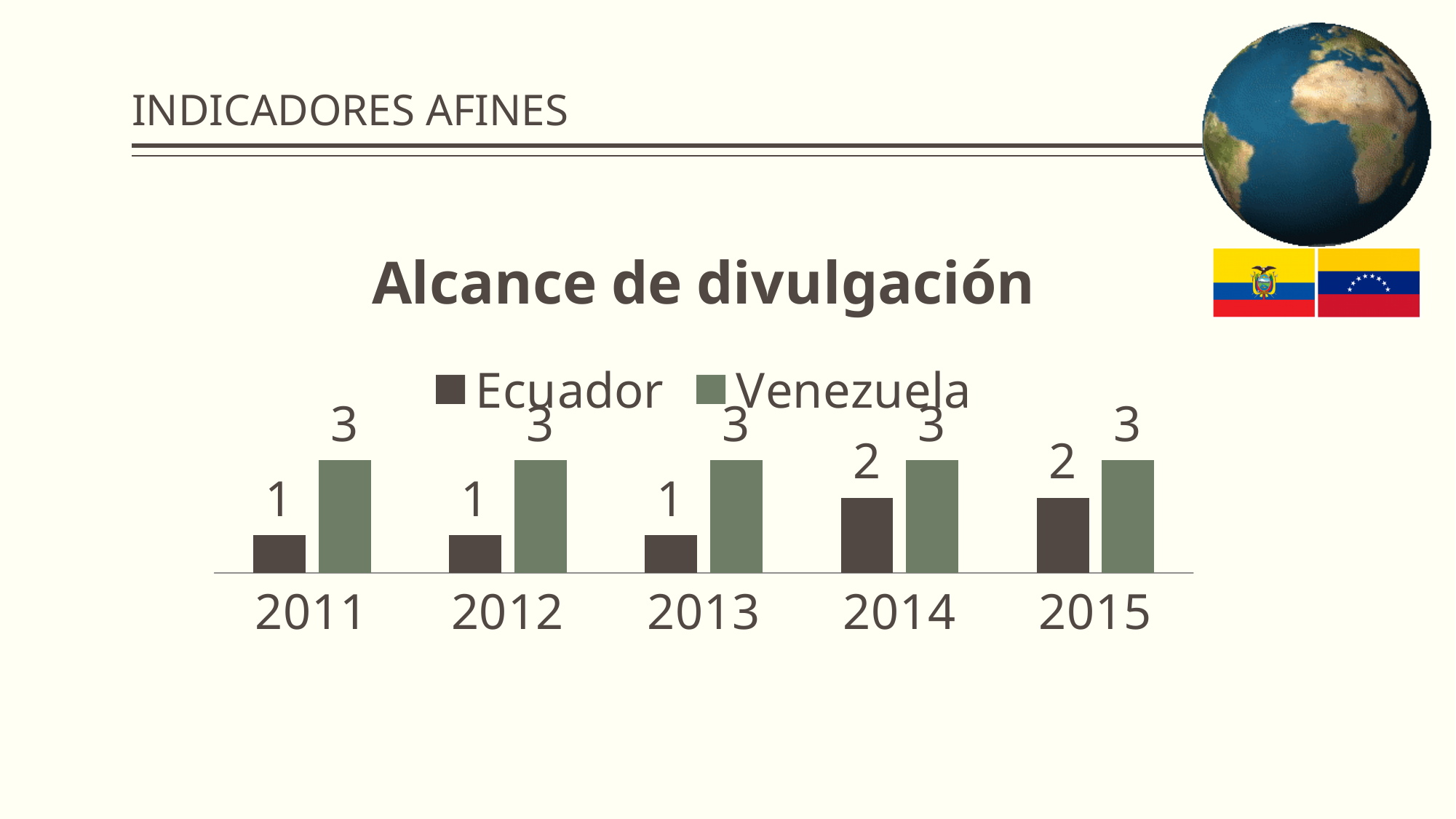
How many years are shown on the x axis? 5 What is the difference between the Venezuela and Ecuador values in 2015? 1 What is the title of the chart? Alcance de divulgación How many series does the legend list? 2 What is the value for Venezuela in 2013? 3 What is the difference between the Venezuela and Ecuador values in 2012? 2 Do the Ecuador values rise or fall from 2011 to 2015? Rise What is the value for Venezuela in 2015? 3 Which series has the larger value in 2014, Ecuador or Venezuela? Venezuela What kind of chart is shown? Bar chart What is the value for Ecuador in 2014? 2 What is the value for Ecuador in 2011? 1